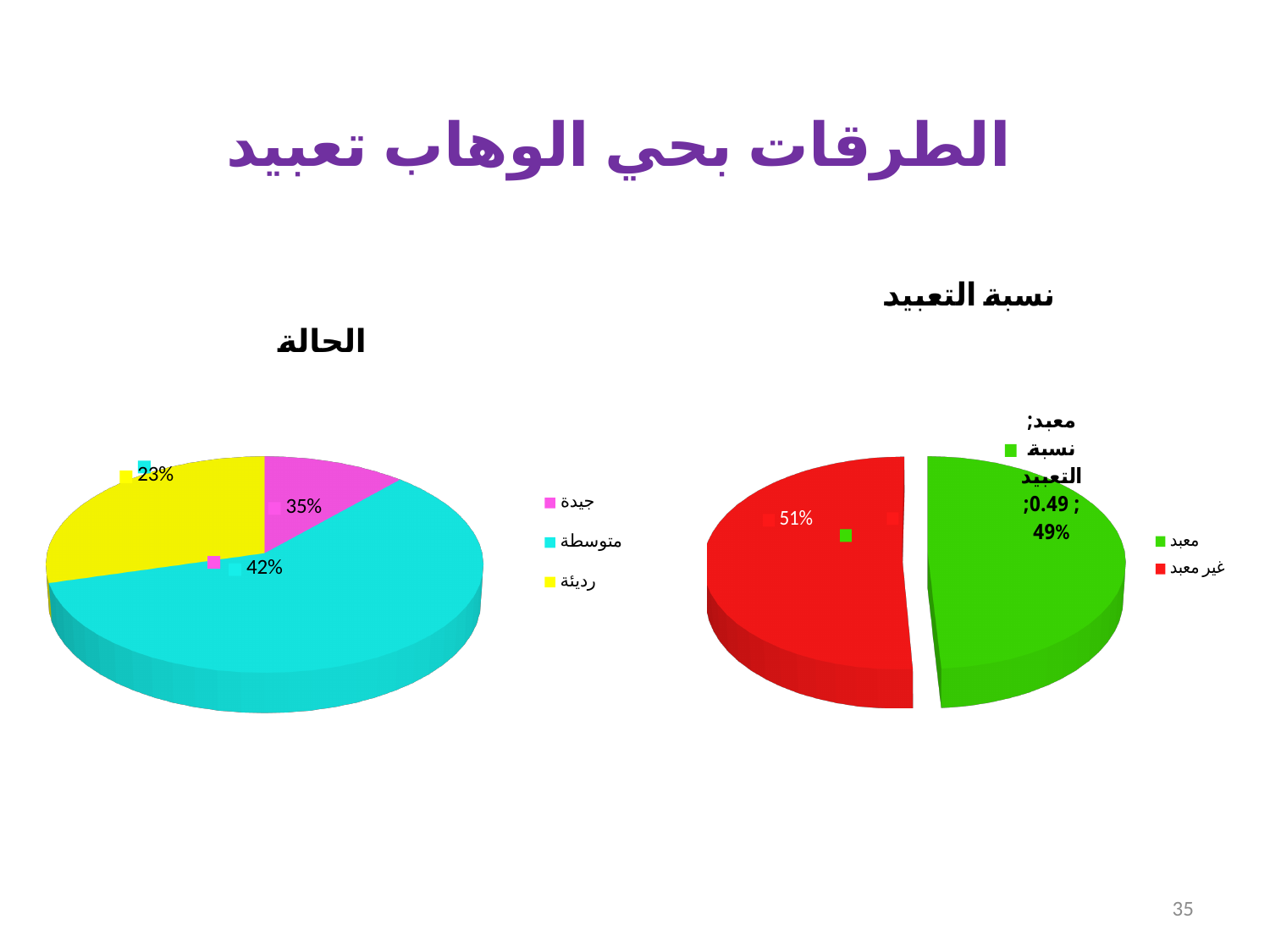
In the chart titled "الحالة", what percentage is shown for the "متوسطة" slice? 42% What type of chart is the chart titled "نسبة التعبيد"? Pie chart In the chart titled "الحالة", which colour represents the "رديئة" category? Yellow In the chart titled "نسبة التعبيد", which is larger, "معبد" or "غير معبد"? غير معبد In the chart titled "الحالة", which category has the largest share? متوسطة In the chart titled "الحالة", what is the difference in percentage points between "متوسطة" and "رديئة"? 19 In the chart titled "الحالة", how many slices does the pie have? 3 In the chart titled "الحالة", what percentage is shown for the "جيدة" slice? 35% In the chart titled "نسبة التعبيد", what percentage is shown for "معبد"? 49% In the chart titled "نسبة التعبيد", what percentage is shown for "غير معبد"? 51% In the chart titled "الحالة", what percentage is shown for the "رديئة" slice? 23%